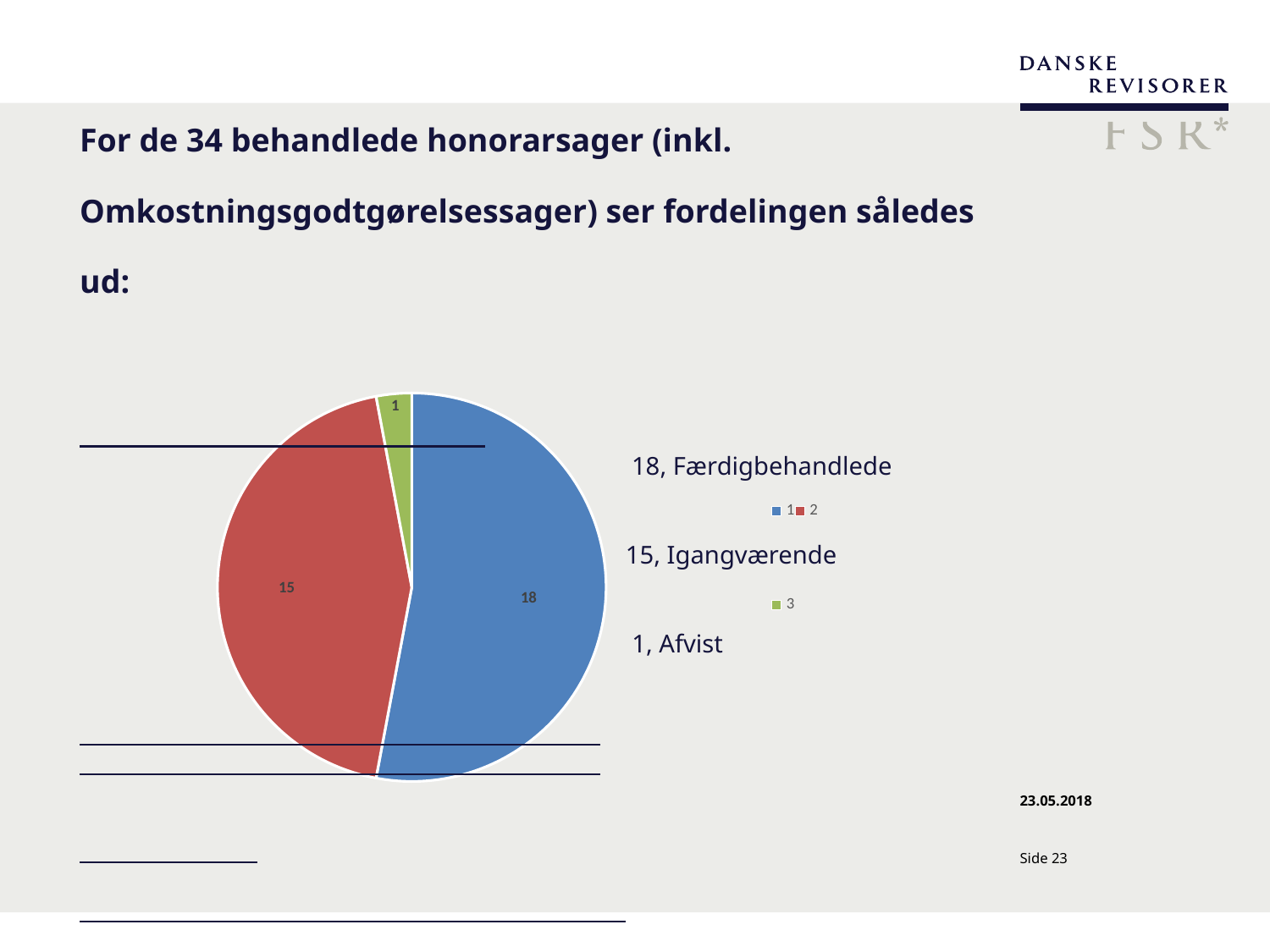
How many slices does the pie chart have? 3 What is the total of all slices in the pie chart? 34 What value is shown for the green slice of the pie chart? 1 Which slice of the pie chart is the largest? 18 (Færdigbehandlede) What entries does the chart legend list? 1, 2, 3 What value is shown for the red slice of the pie chart? 15 What is the difference between the blue slice (18) and the red slice (15)? 3 What kind of chart is shown on the slide? Pie chart Which slice of the pie chart is the smallest? 1 (Afvist) Which is larger, the Færdigbehandlede slice or the Igangværende slice? Færdigbehandlede What value is shown for the blue slice of the pie chart? 18 How many cases are labelled Igangværende on the slide? 15